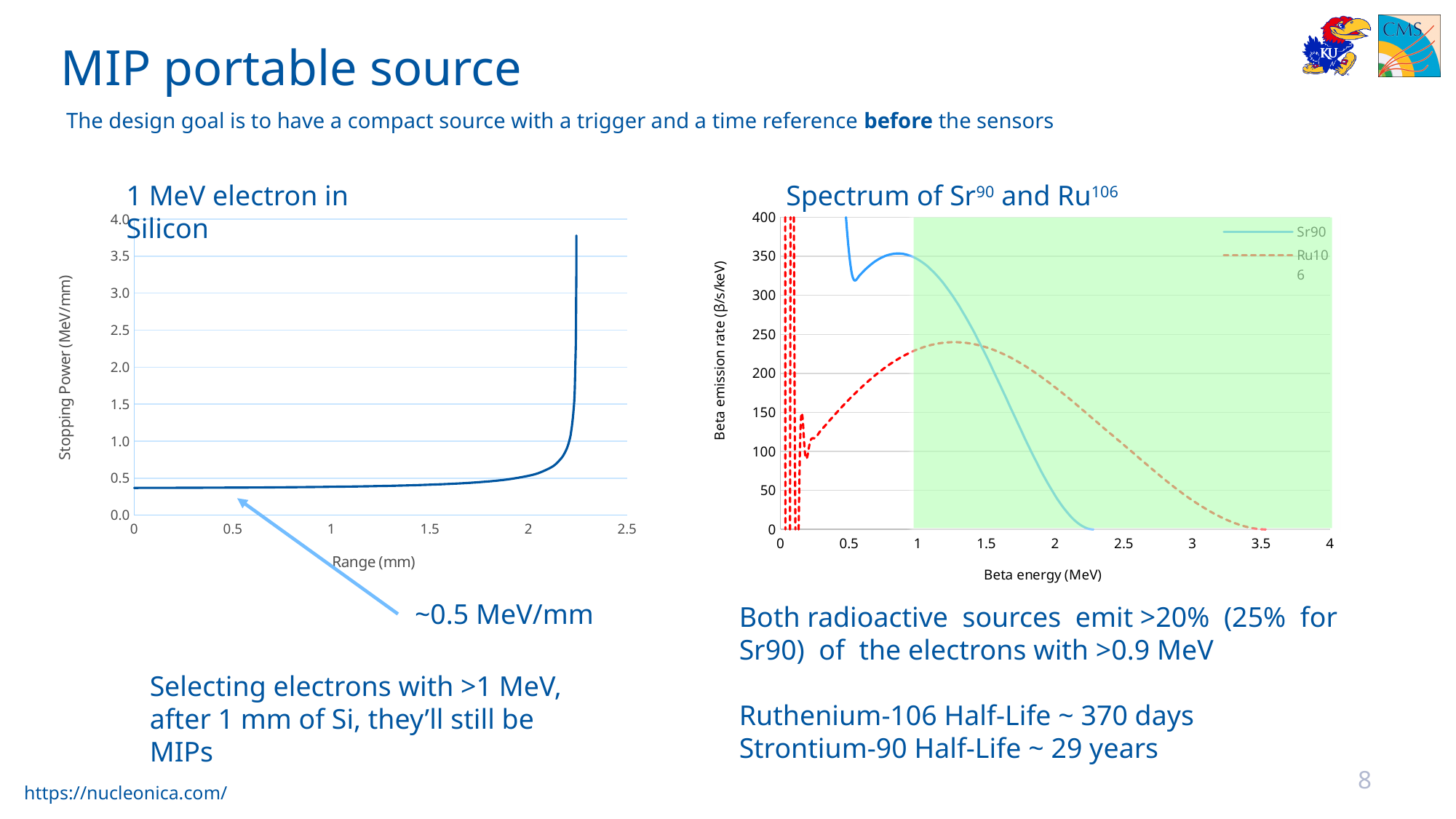
In the 'Spectrum of Sr90 and Ru106' chart, which series has the higher emission rate at 1 MeV, Sr90 or Ru106? Sr90 In the 'Spectrum of Sr90 and Ru106' chart, does the Sr90 emission rate rise or fall between 1 MeV and 2 MeV? fall In the '1 MeV electron in Silicon' chart, is the stopping power at a range of 1 mm greater or less than 1.0? less In the 'Spectrum of Sr90 and Ru106' chart, is the Sr90 emission rate at 1 MeV greater or less than 300? greater What is the y-axis title of the '1 MeV electron in Silicon' chart? Stopping Power (MeV/mm) In the 'Spectrum of Sr90 and Ru106' chart, which series is drawn with a dashed line? Ru106 What kind of chart is the '1 MeV electron in Silicon' chart? line chart In the 'Spectrum of Sr90 and Ru106' chart, which series has the higher emission rate at 2 MeV, Sr90 or Ru106? Ru106 In the '1 MeV electron in Silicon' chart, does the stopping power rise or fall as the range increases toward 2.5 mm? rise In the 'Spectrum of Sr90 and Ru106' chart, is the Ru106 emission rate at 3 MeV greater or less than 100? less What kind of chart is the 'Spectrum of Sr90 and Ru106' chart? line chart How many series does the legend of the 'Spectrum of Sr90 and Ru106' chart list? 2